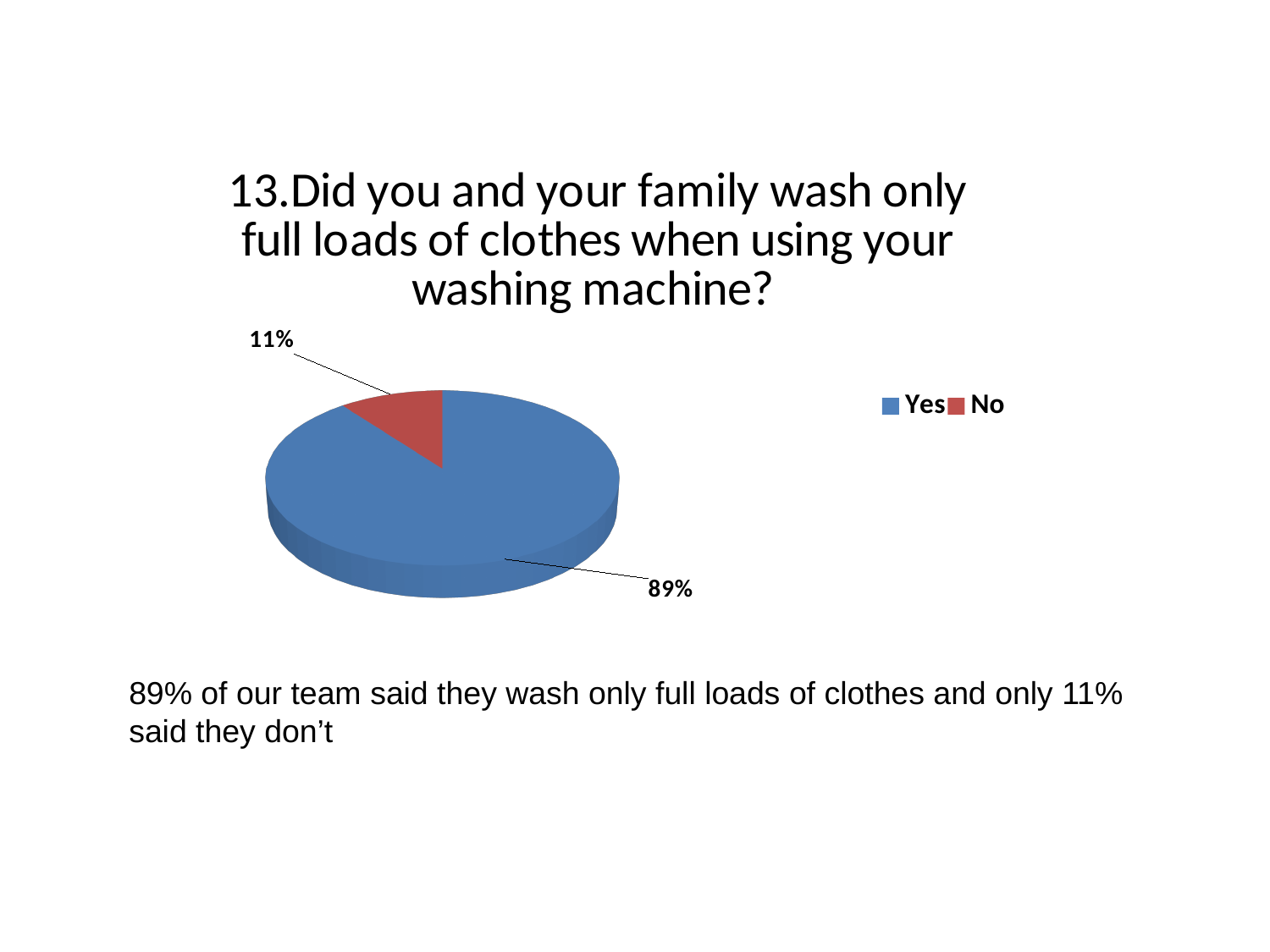
Which category has the smallest slice of the pie? No How many categories does the pie chart show? 2 What share of the pie does the No slice represent? 11% What share of the pie does the Yes slice represent? 89% What is the difference in percentage points between the Yes and No slices? 78 What type of chart is shown on the slide? pie chart Which is larger, the Yes slice or the No slice? Yes What colour is the Yes slice in the pie chart? blue Which category has the largest slice of the pie? Yes How many entries does the legend list? 2 What colour is the No slice in the pie chart? red